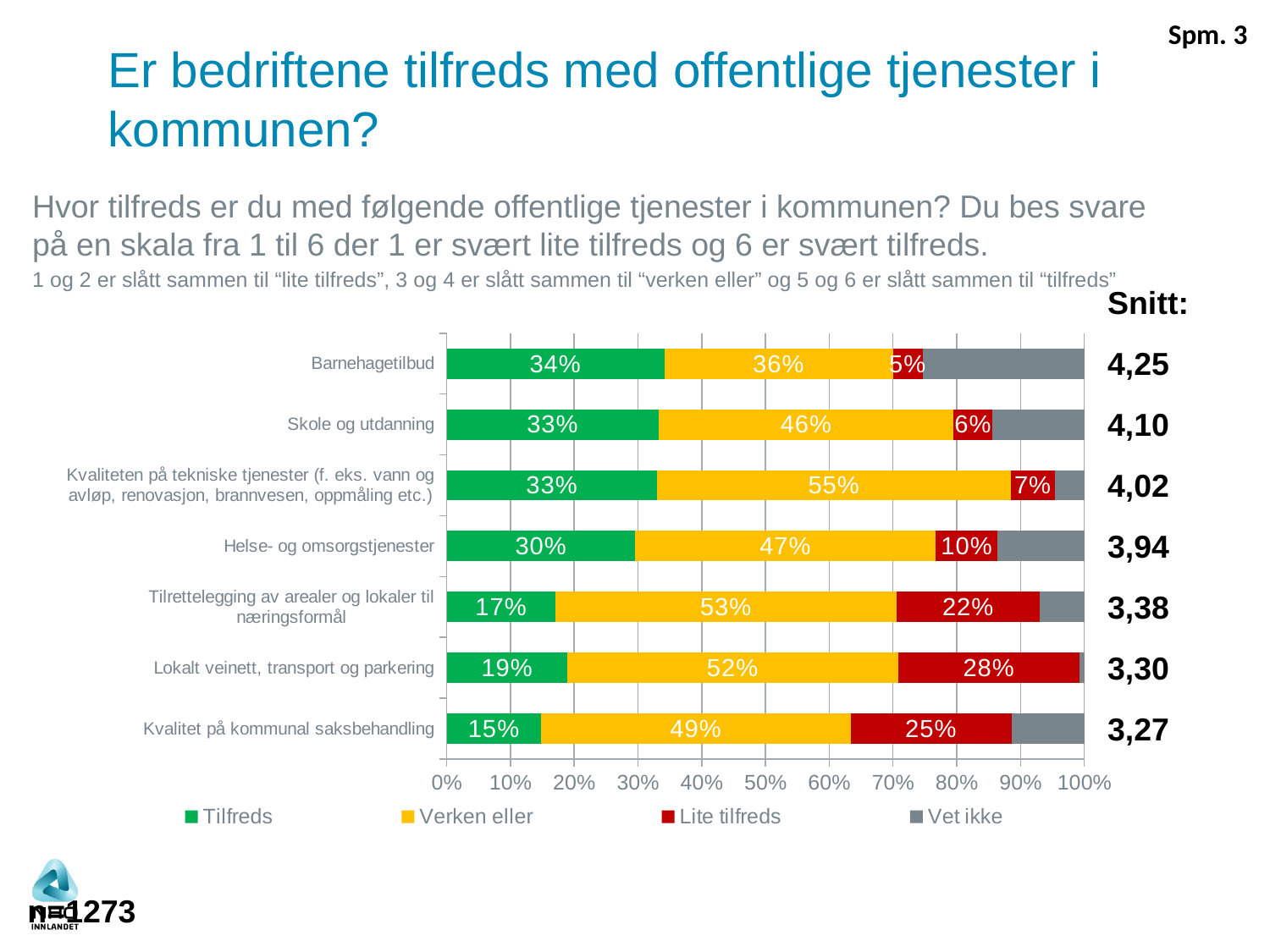
What kind of chart is shown on the slide? Stacked bar chart What is the difference in percentage points between the "Tilfreds" share for Barnehagetilbud and for Helse- og omsorgstjenester? 4 percentage points Which has a larger "Lite tilfreds" share: Tilrettelegging av arealer og lokaler til næringsformål or Kvalitet på kommunal saksbehandling? Kvalitet på kommunal saksbehandling What is the "Verken eller" share for Kvaliteten på tekniske tjenester? 55% What percentage of respondents answered "Tilfreds" for Barnehagetilbud? 34% How many categories (public services) are shown in the chart? 7 How many series does the legend list? 4 What is the "Lite tilfreds" share for Lokalt veinett, transport og parkering? 28% Which category has the highest "Tilfreds" share? Barnehagetilbud Which category has the lowest "Tilfreds" share? Kvalitet på kommunal saksbehandling What is the Snitt (average) value shown for Helse- og omsorgstjenester? 3,94 Which category has the highest "Lite tilfreds" share? Lokalt veinett, transport og parkering